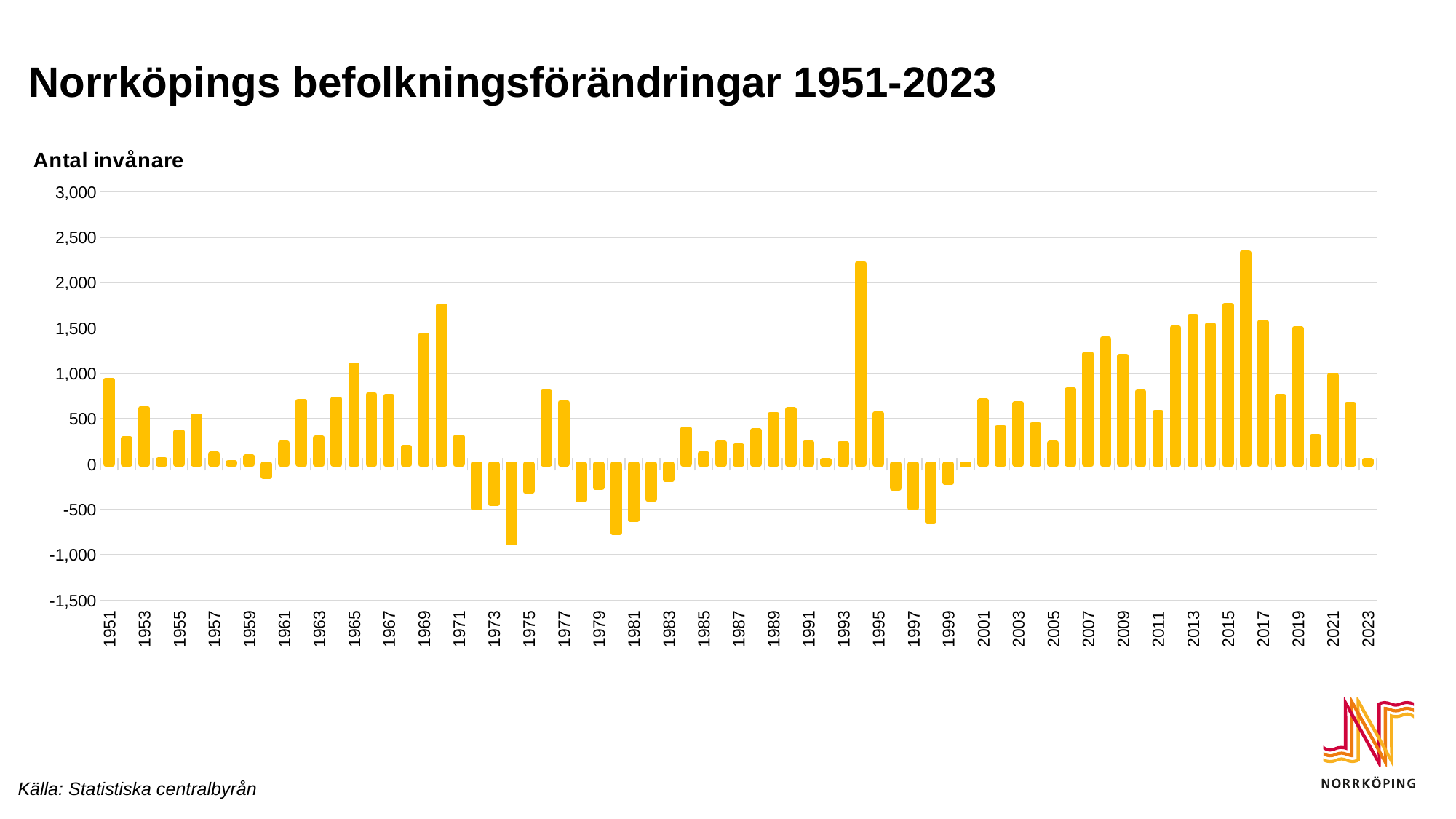
What kind of chart is shown on the slide? bar chart Is the value for 1994 greater or less than 2,000? greater Do the values rise or fall from 2005 to 2008? rise Is the value for 1974 greater or less than -500? less Is the value for 1998 greater or less than -500? less Which year has the larger value, 1969 or 1970? 1970 Which year has the highest population change in the chart? 2016 Which year has the lowest (most negative) population change in the chart? 1974 What is the label on the vertical axis of the chart? Antal invånare Which year has the larger value, 2016 or 2017? 2016